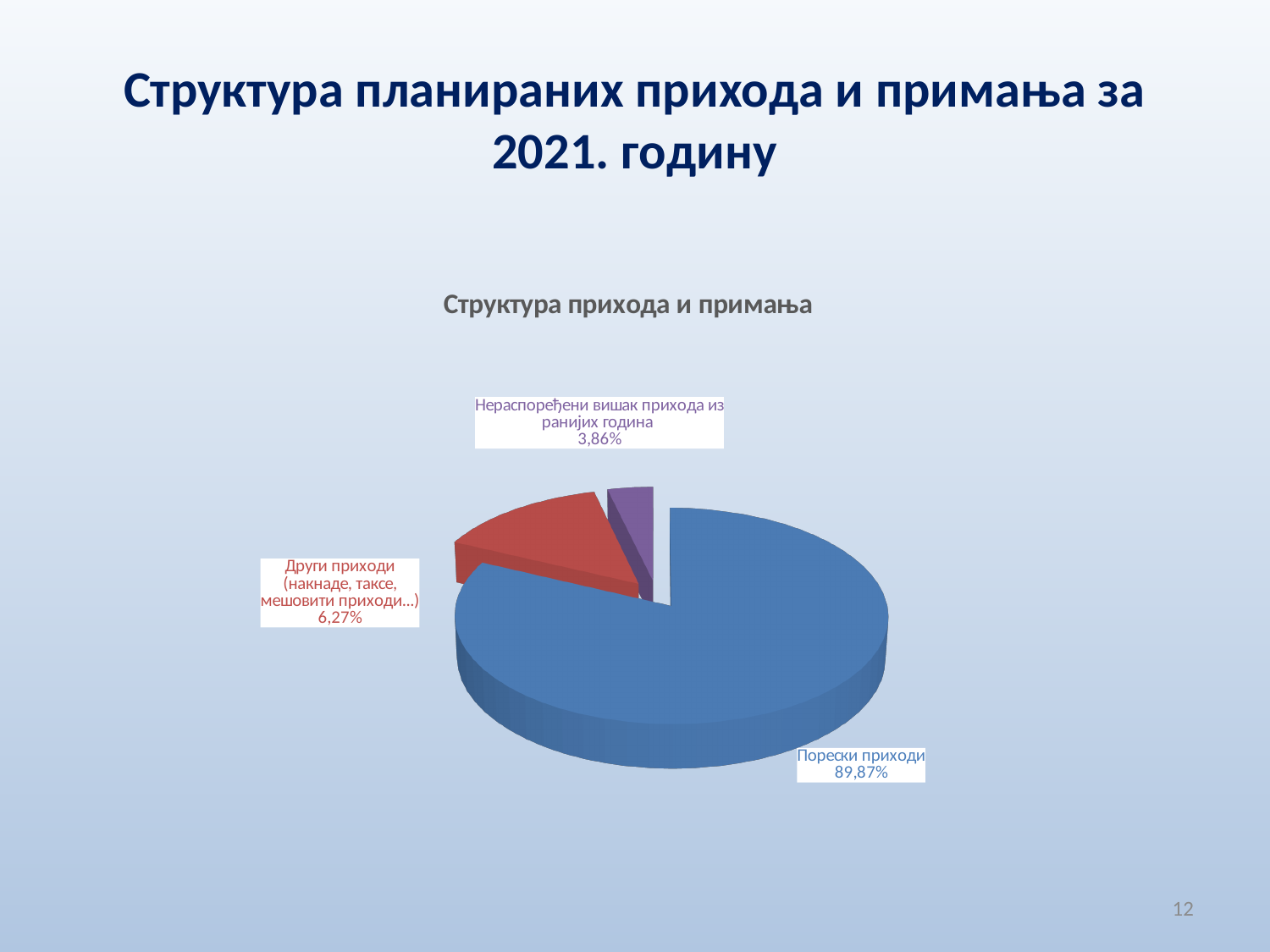
What is the difference between the shares of Порески приходи and Други приходи? 83,60% How many slices does the pie chart have? 3 Which category has the largest slice of the pie? Порески приходи What share of the pie is Порески приходи? 89,87% Which is larger: Други приходи or Нераспоређени вишак прихода из ранијих година? Други приходи What is the difference between the shares of Други приходи and Нераспоређени вишак прихода из ранијих година? 2,41% What share of the pie is Нераспоређени вишак прихода из ранијих година? 3,86% What share of the pie is Други приходи (накнаде, таксе, мешовити приходи...)? 6,27% Which category has the smallest slice of the pie? Нераспоређени вишак прихода из ранијих година What kind of chart is shown on the slide? pie chart What is the chart's title? Структура прихода и примања What colour is the slice for Порески приходи? blue